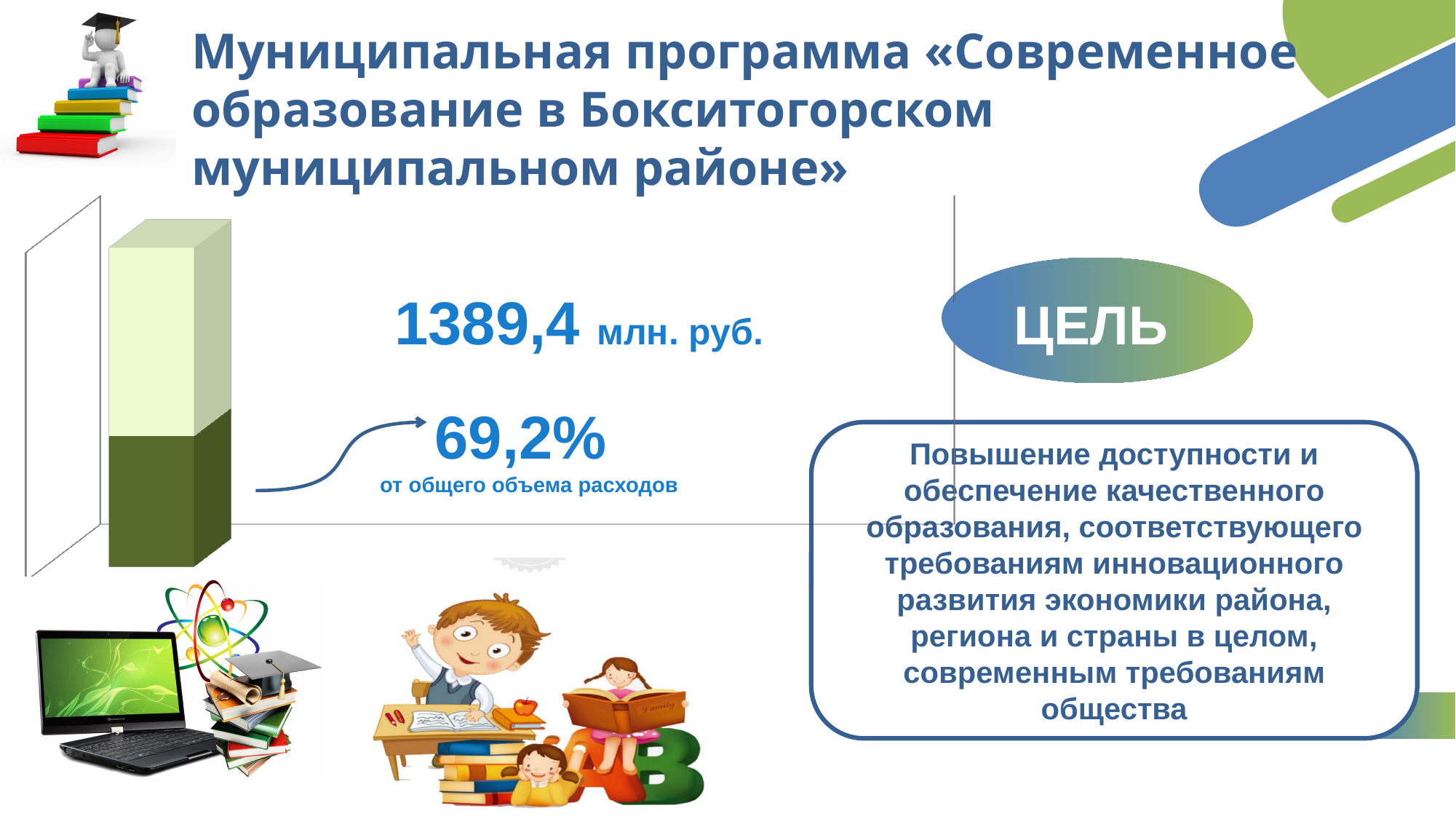
What percentage is printed next to the dark green segment of the bar? 69,2% What amount in million rubles is printed beside the bar? 1389,4 млн. руб. What kind of chart is shown on the left of the slide? bar chart What does the 69,2% label say it is a share of? от общего объема расходов How many segments does the stacked bar have? 2 Is the percentage printed for the dark green segment greater or less than 50%? greater What colour is the bar segment that the 69,2% arrow points from? dark green What share of total expenditure does the labelled segment of the bar represent? 69,2%